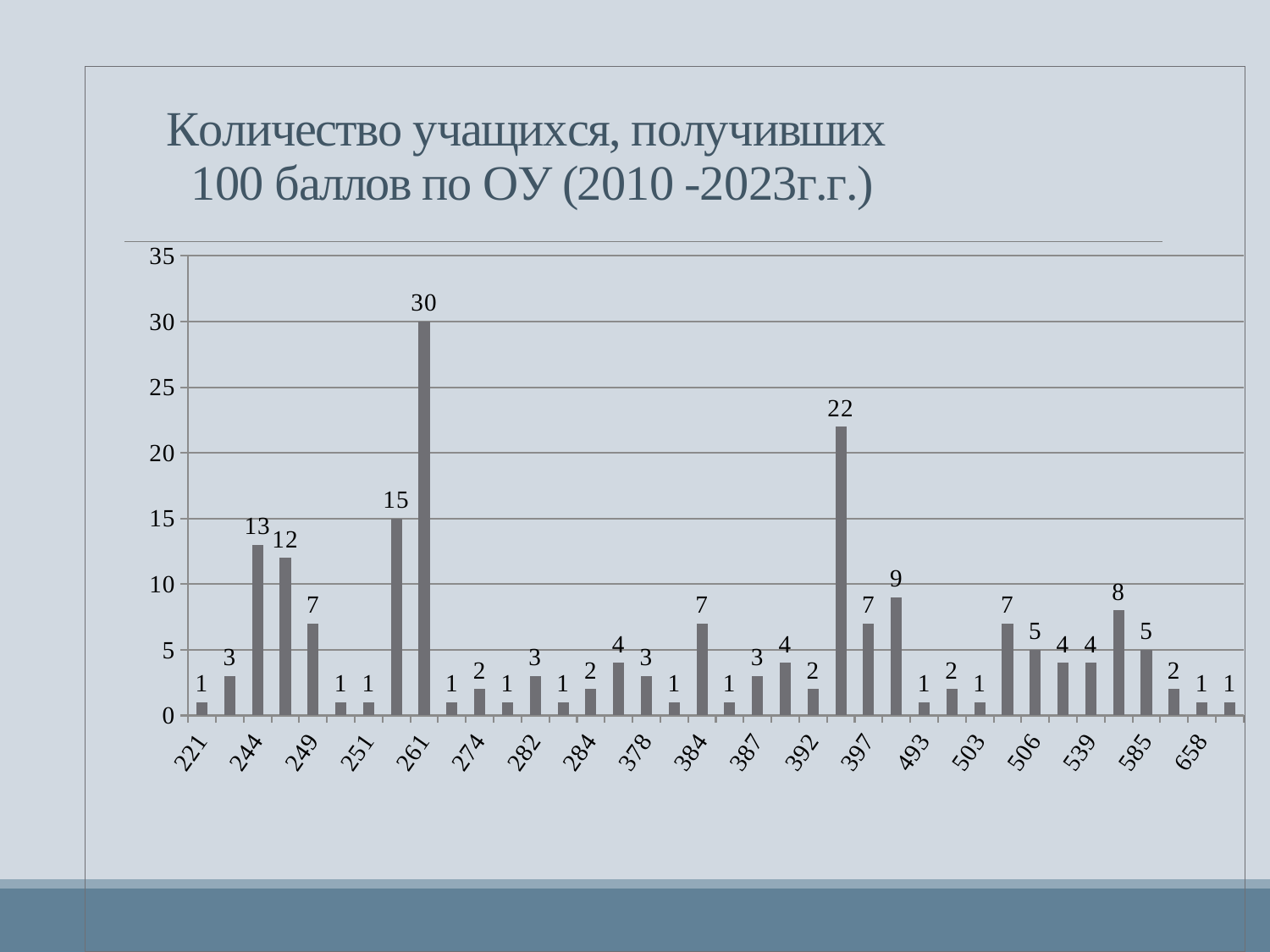
What is the difference between the values for 261 and 244? 17 What is the title of the chart? Количество учащихся, получивших 100 баллов по ОУ (2010 -2023г.г.) Which is larger, the value for 384 or the value for 387? 384 What is the value for category 397? 7 What is the value for category 261? 30 Is the value for 261 greater or less than 25? greater What is the value for category 506? 5 What type of chart is shown on the slide? bar chart What is the value for category 244? 13 What is the value for category 585? 5 What is the difference between the values for 249 and 274? 5 Which category has the highest value? 261